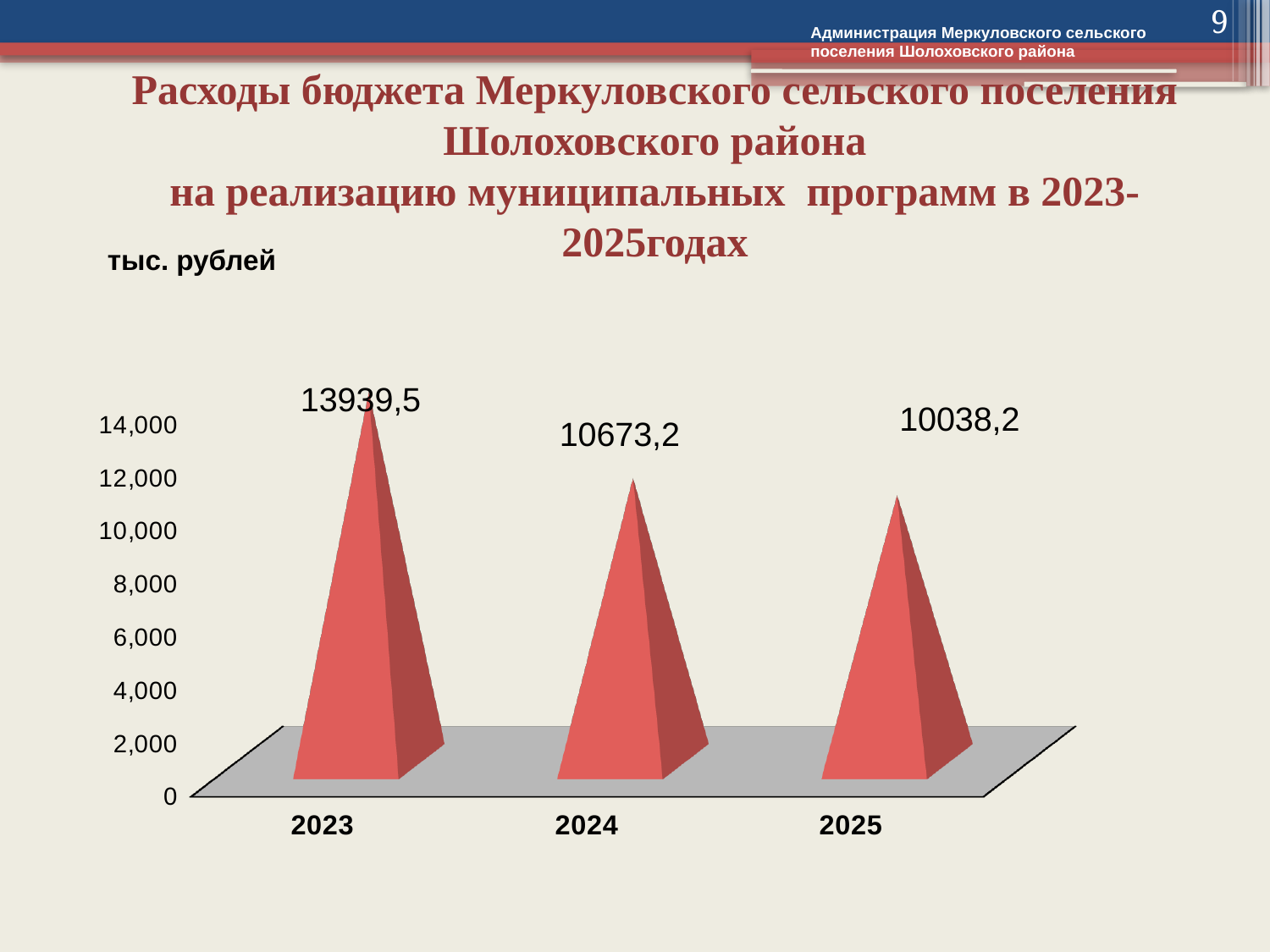
What is the value for 2024? 10673,2 Which year has the lowest value? 2025 Do the values rise or fall from 2023 to 2025? fall What is the value for 2025? 10038,2 Is the value for 2023 greater or less than 12,000? greater What is the value for 2023? 13939,5 Which is larger, the value for 2024 or the value for 2025? 2024 What is the difference between the values for 2024 and 2025? 635,0 What is the difference between the values for 2023 and 2024? 3266,3 Which year has the highest value? 2023 What kind of chart is shown on the slide? bar chart How many years are shown on the chart? 3